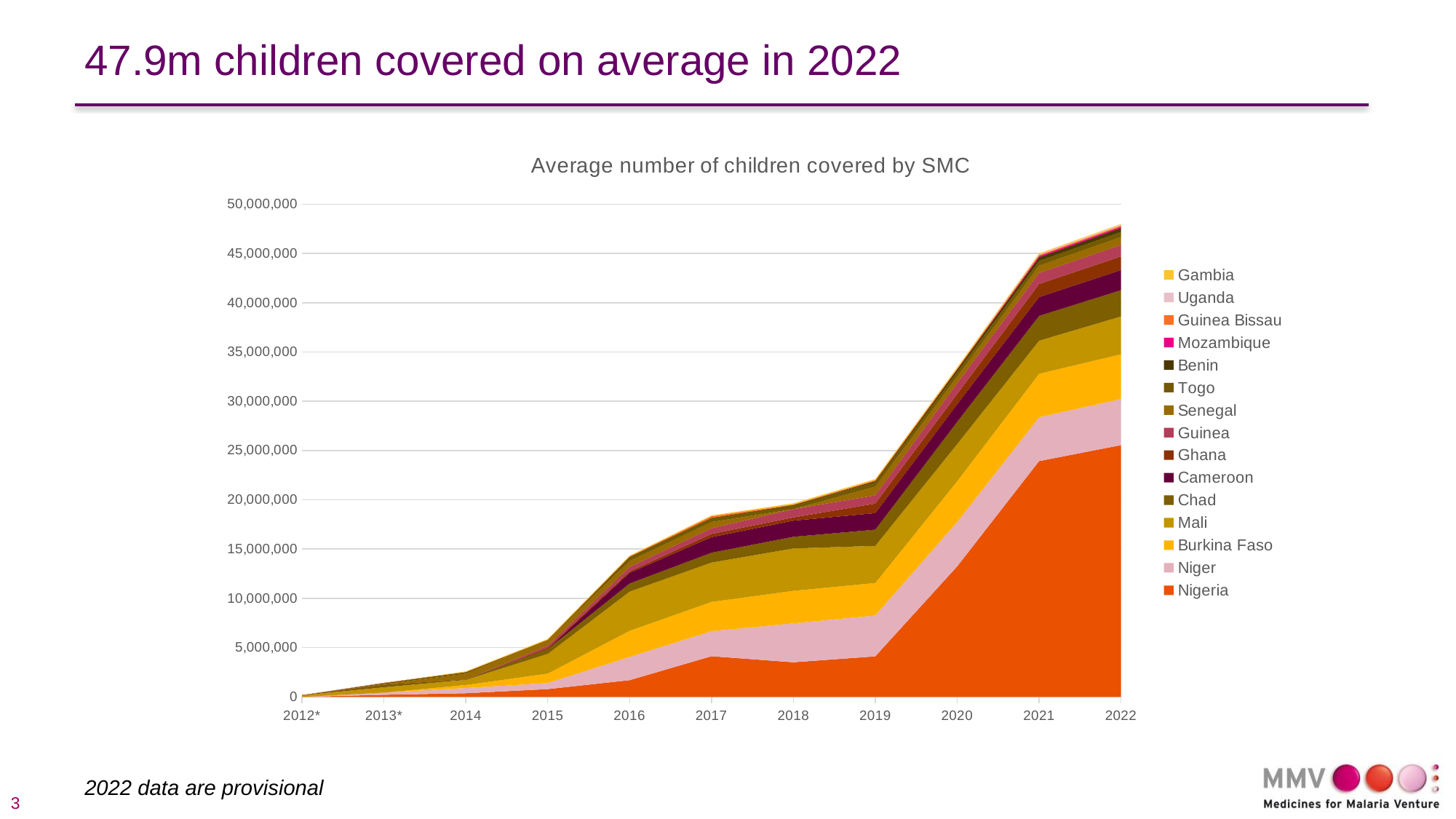
Do the total values generally rise or fall from 2012* to 2022? Rise How many years are shown along the x axis? 11 Which year has the lowest total number of children covered? 2012* Is the total number of children covered in 2022 greater or less than 45,000,000? greater How many countries does the legend list? 15 Is the total number of children covered in 2019 greater or less than 25,000,000? less Is the value for Nigeria in 2022 greater or less than 20,000,000? greater Which year has the highest total number of children covered? 2022 Which country's series is plotted at the bottom of the stacked areas? Nigeria Which year has a larger total number of children covered, 2019 or 2021? 2021 What is the title of the chart? Average number of children covered by SMC What kind of chart is shown on the slide? Stacked area chart